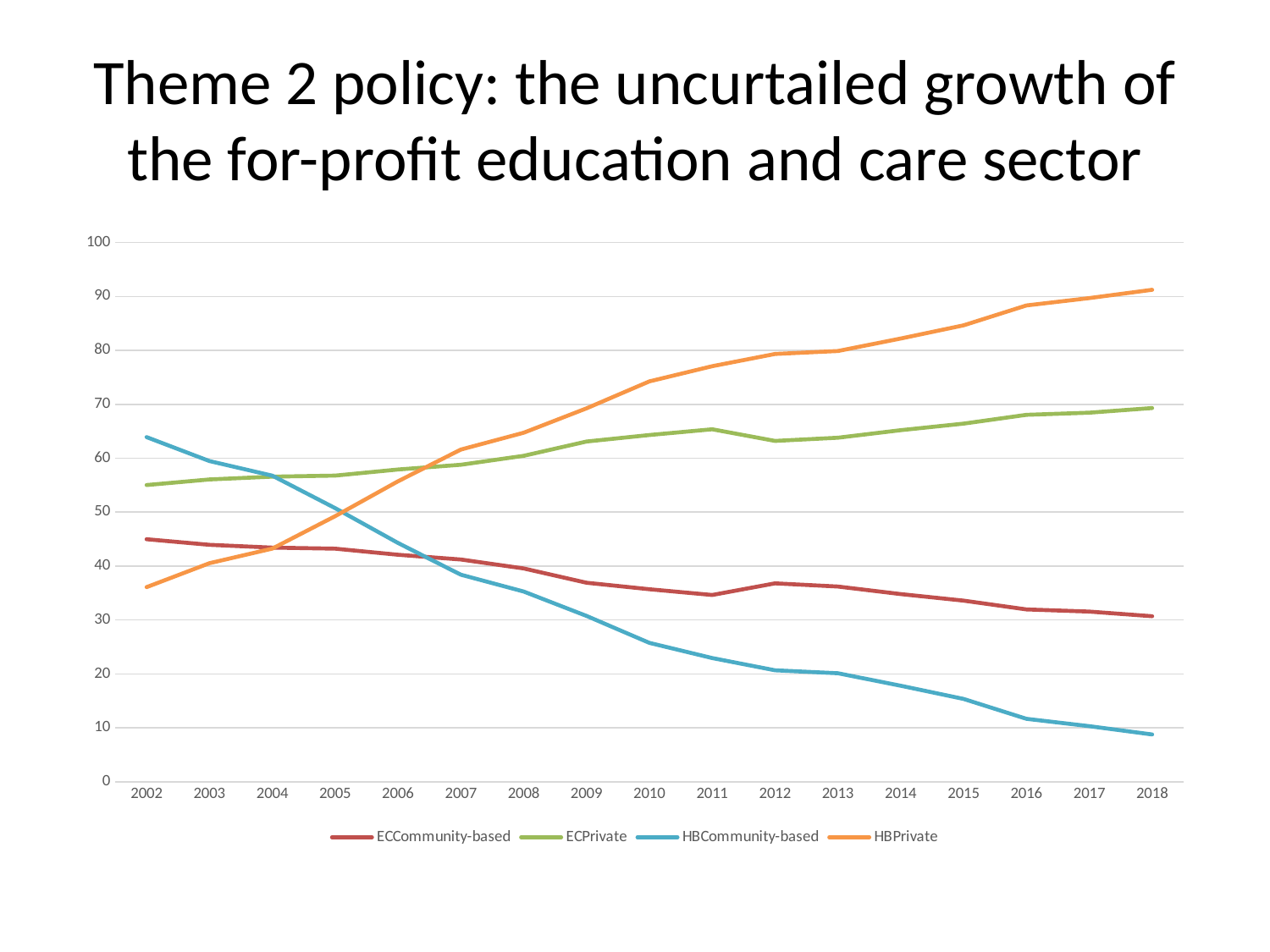
Which series has the highest value in 2002? HBCommunity-based Which series has the lowest value in 2018? HBCommunity-based How many years are plotted along the x axis? 17 Is the value for HBCommunity-based in 2018 greater or less than 20? less In 2002, which is larger: HBCommunity-based or ECPrivate? HBCommunity-based Does the HBPrivate line rise or fall from 2002 to 2018? Rises Which series has the highest value in 2018? HBPrivate Does the HBCommunity-based line rise or fall from 2002 to 2018? Falls What kind of chart is shown on the slide? Line chart Which series is drawn in orange in the legend? HBPrivate Is the value for HBPrivate in 2018 greater or less than 80? greater How many series does the legend list? 4